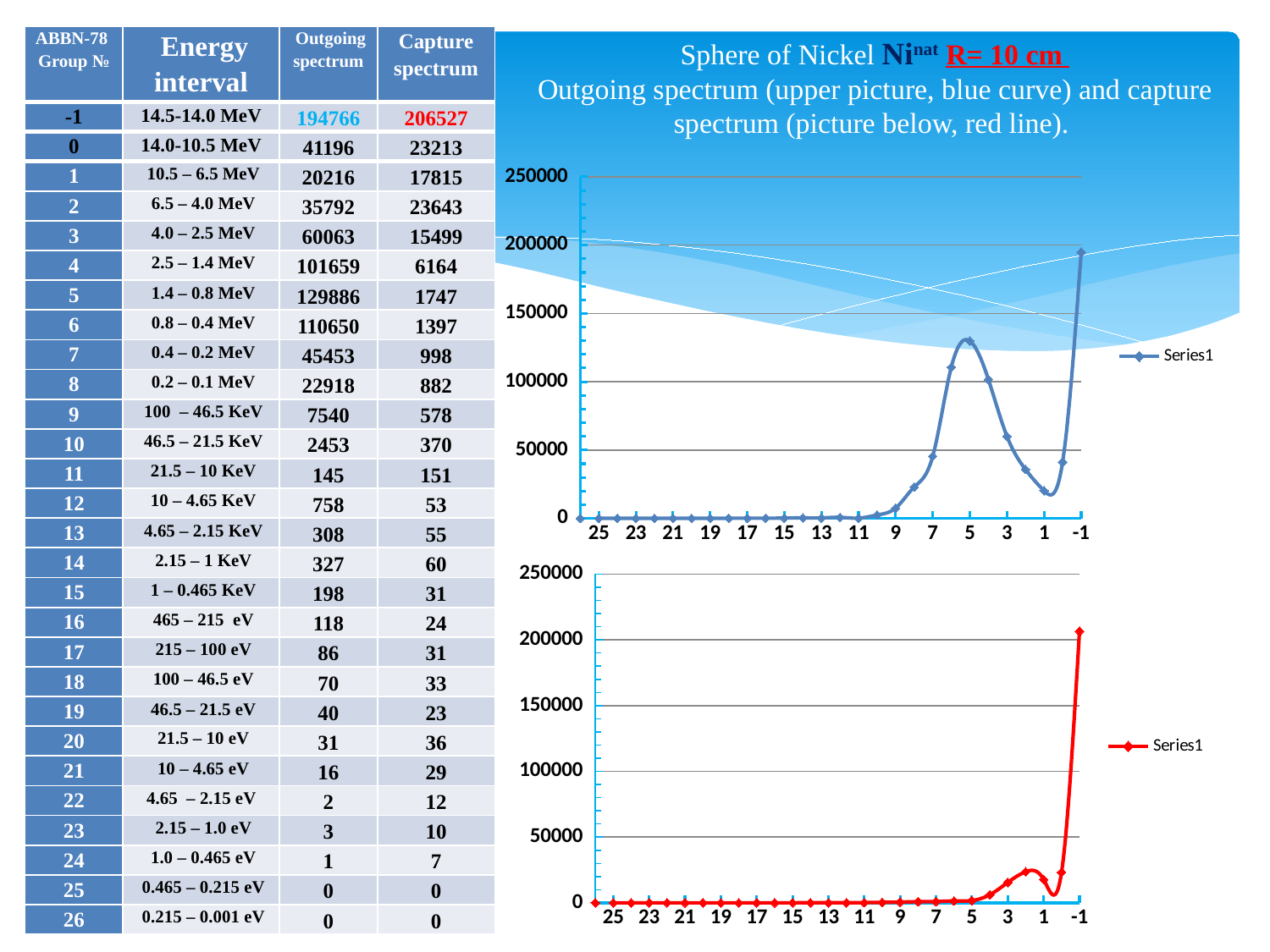
In the upper chart (blue curve), which is larger: the value at group 5 or the value at group -1? -1 In the upper chart (blue curve), is the value at group 9 greater or less than 50000? less In the upper chart (blue curve), is the value at group 5 greater or less than 100000? greater How many series does the legend of the lower chart list? 1 In the lower chart (red line), at which x-axis group is the value highest? -1 In the lower chart (red line), is the value at group -1 greater or less than 200000? greater What kind of chart is the lower chart (red line)? line chart In the upper chart (blue curve), at which x-axis group is the value highest? -1 What is the legend entry shown next to the upper chart? Series1 What kind of chart is the upper chart (blue curve)? line chart